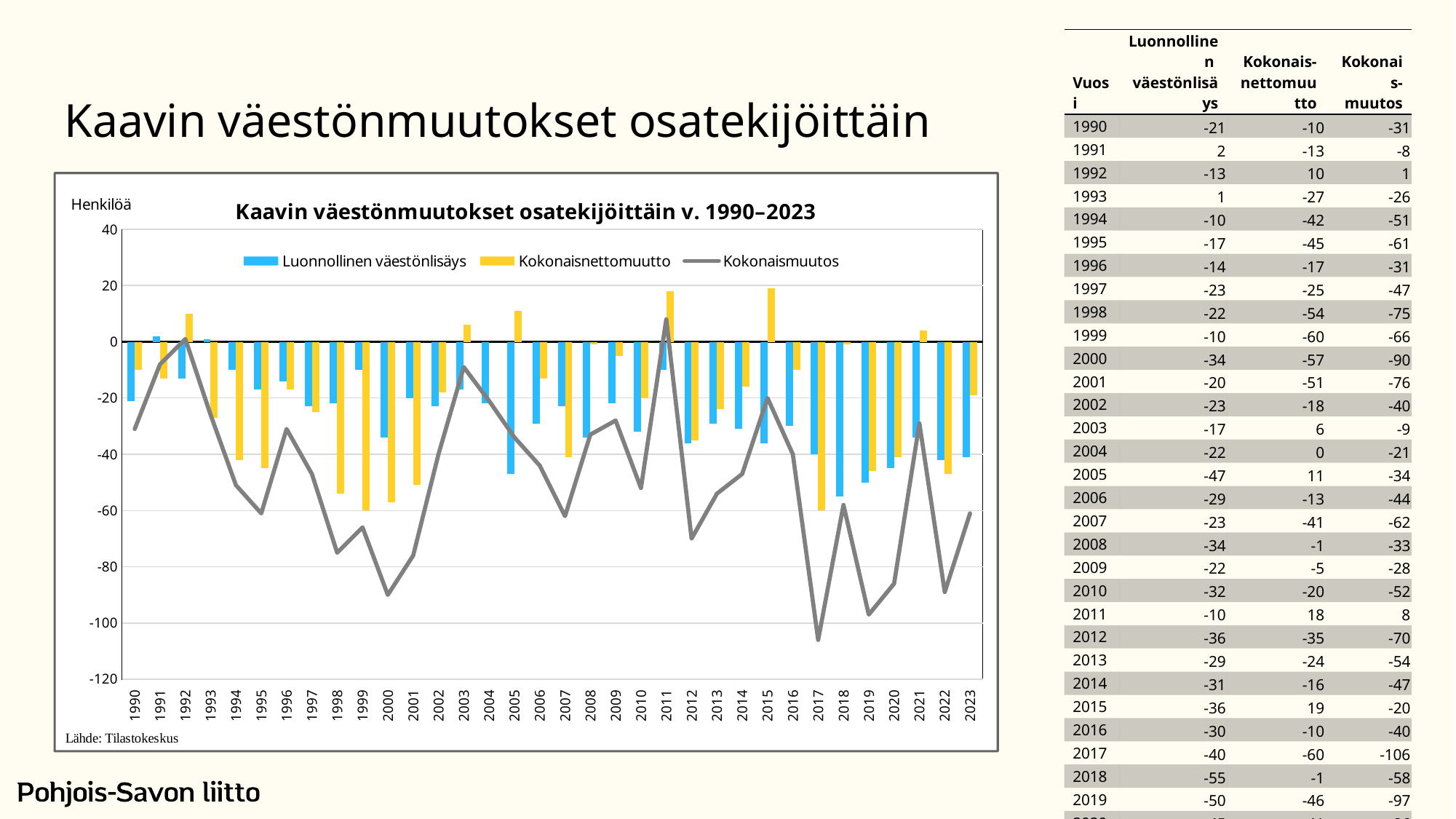
Does the Kokonaismuutos line rise or fall from 2015 to 2017? fall How many series does the chart legend list? 3 What is the title of the chart? Kaavin väestönmuutokset osatekijöittäin v. 1990–2023 Is the Kokonaismuutos value for 2000 greater or less than -80? less In which year is Kokonaismuutos at its lowest? 2017 How many years are shown on the x axis of the chart? 34 What is the Kokonaismuutos value for 2017? -106 What kind of chart is shown on the slide? bar and line chart What is the Kokonaisnettomuutto value for 1998? -54 Which year has the higher Kokonaismuutos value, 2011 or 2012? 2011 Is the Luonnollinen väestönlisäys value for 2018 greater or less than -40? less What is the difference between Luonnollinen väestönlisäys (-40) and Kokonaisnettomuutto (-60) in 2017? 20